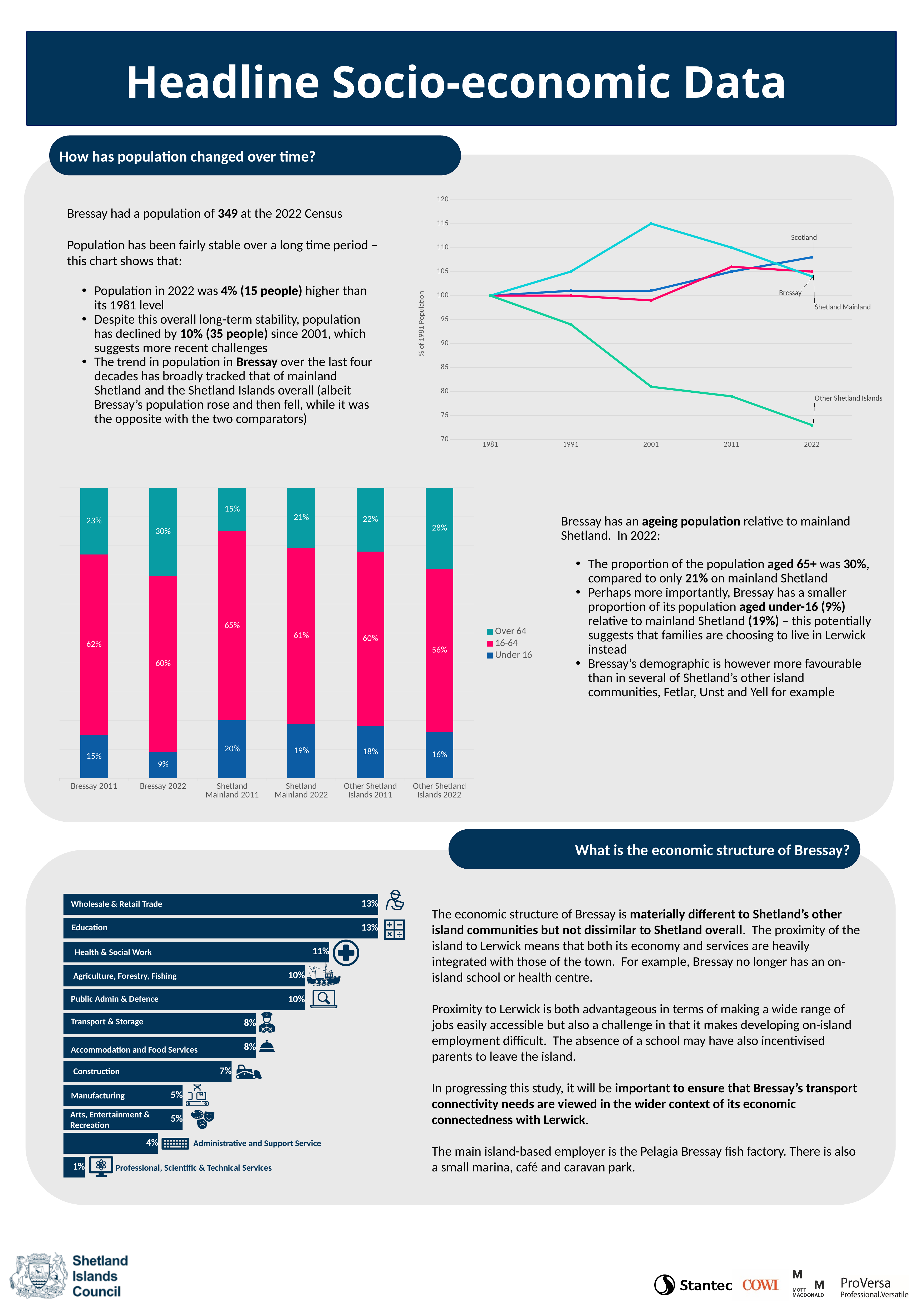
In the stacked bar chart of age structure, what is the total of the Bressay 2011 bar? 100% In the stacked bar chart of age structure, what percentage of Bressay's population in 2022 was Under 16? 9% In the economic structure bar chart, which is larger: Transport & Storage or Manufacturing? Transport & Storage In the line chart showing population as % of 1981, is the value for Other Shetland Islands in 2022 greater or less than 75? less In the economic structure bar chart, which sector has the lowest value? Professional, Scientific & Technical Services In the stacked bar chart of age structure, which category has the highest 16-64 share? Shetland Mainland 2011 In the line chart showing population as % of 1981, what kind of chart is it? line chart In the stacked bar chart of age structure, what is the difference between the Over 64 share for Bressay 2022 and Shetland Mainland 2022? 9 percentage points In the stacked bar chart of age structure, how many series does the legend list? 3 In the line chart showing population as % of 1981, does the Other Shetland Islands line rise or fall from 1981 to 2022? fall In the economic structure bar chart, what is the value for Construction? 7% In the line chart showing population as % of 1981, how many census years are shown on the x axis? 5